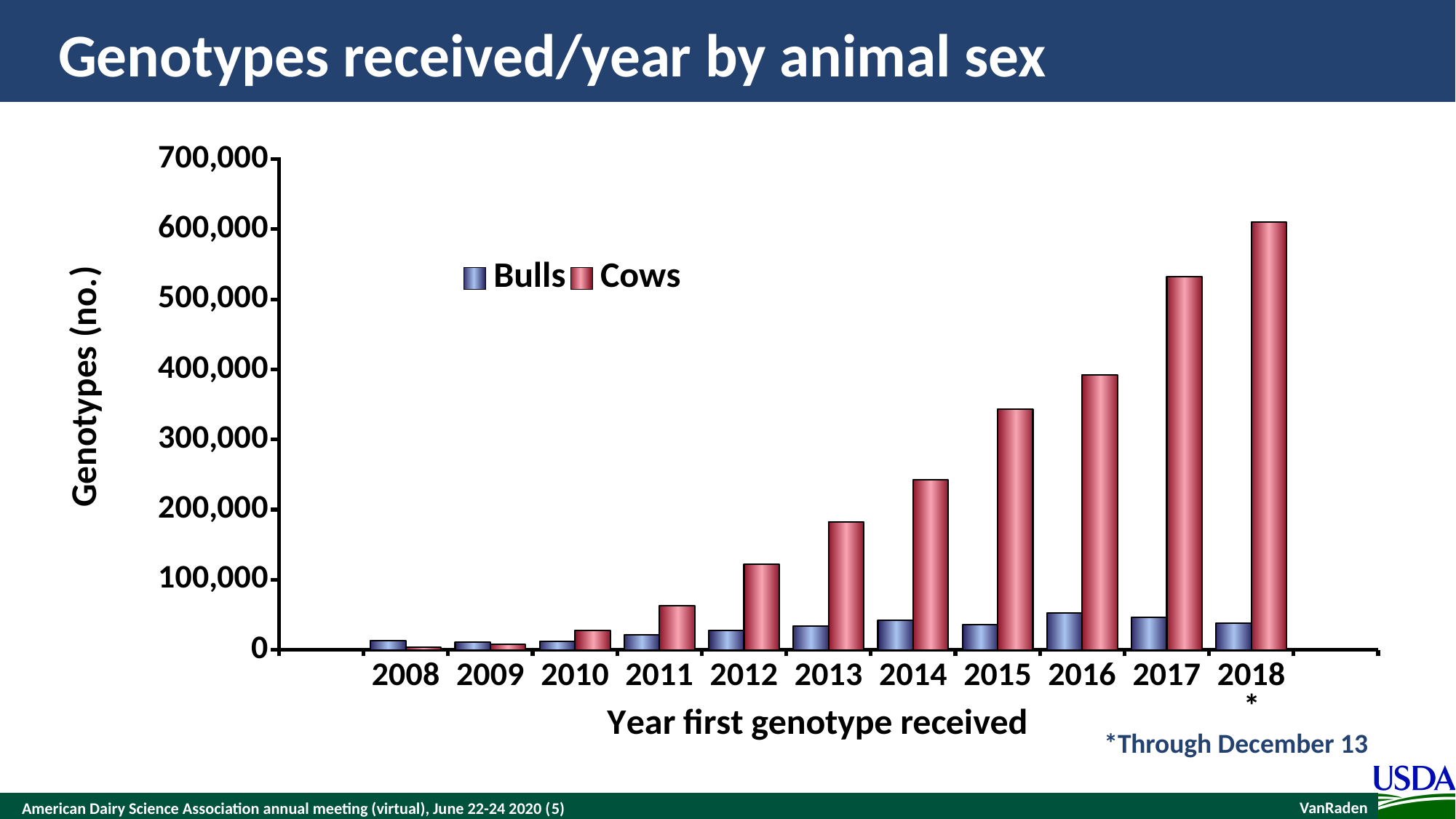
What kind of chart is shown on the slide? bar chart How many years are shown on the x axis? 11 Which year has the lowest value for Cows? 2008 How many series does the legend list? 2 What is the label of the y axis? Genotypes (no.) Which year has the highest value for Cows? 2018 Is the value for Cows in 2017 greater or less than 500,000? greater In 2018, which is larger, the value for Bulls or the value for Cows? Cows Do the values for Cows rise or fall from 2008 to 2018? rise Is the value for Bulls in 2016 greater or less than 100,000? less Is the value for Cows in 2013 greater or less than 200,000? less